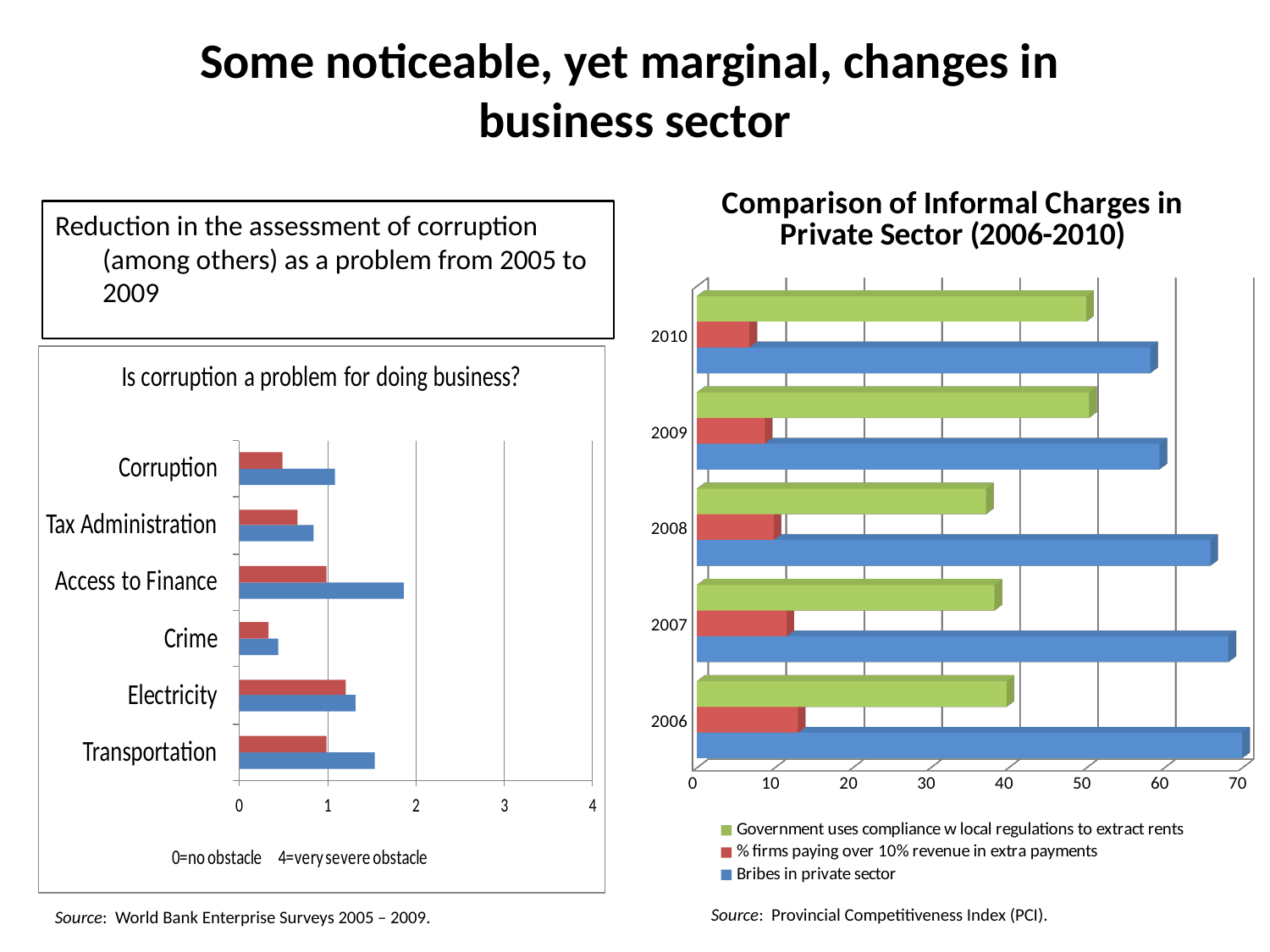
In the 'Is corruption a problem for doing business?' chart, is the blue bar for Access to Finance greater or less than 1? greater In the 'Comparison of Informal Charges in Private Sector (2006-2010)' chart, does the 'Bribes in private sector' series rise or fall from 2006 to 2010? fall In the 'Comparison of Informal Charges in Private Sector (2006-2010)' chart, which colour represents 'Bribes in private sector'? blue In the 'Comparison of Informal Charges in Private Sector (2006-2010)' chart, is the value for '% firms paying over 10% revenue in extra payments' in 2010 greater or less than 10? less How many categories are shown in the 'Is corruption a problem for doing business?' chart? 6 What kind of chart is the 'Is corruption a problem for doing business?' chart? bar chart How many series does the legend of the 'Comparison of Informal Charges in Private Sector (2006-2010)' chart list? 3 In the 'Is corruption a problem for doing business?' chart, which category has the shortest blue bar? Crime In the 'Is corruption a problem for doing business?' chart, is the red bar for Crime greater or less than 1? less In the 'Is corruption a problem for doing business?' chart, which category has the longest blue bar? Access to Finance How many years are shown in the 'Comparison of Informal Charges in Private Sector (2006-2010)' chart? 5 In the 'Comparison of Informal Charges in Private Sector (2006-2010)' chart, which year has the highest value for 'Bribes in private sector'? 2006